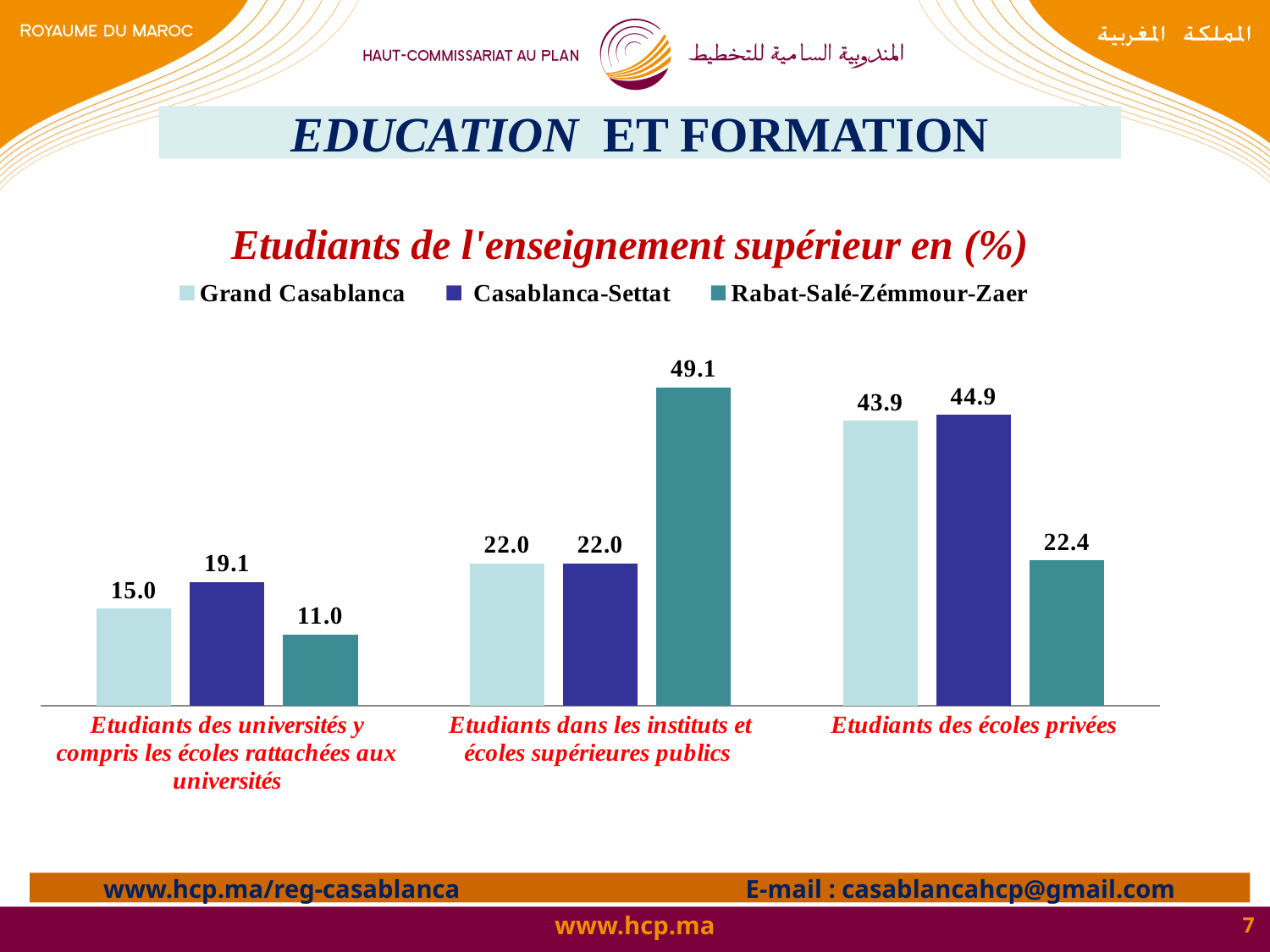
What kind of chart is shown on the slide? Bar chart What is the difference between the Casablanca-Settat and Grand Casablanca values for 'Etudiants des écoles privées'? 1.0 Which series has the highest value in the category 'Etudiants des écoles privées'? Casablanca-Settat What is the value for Rabat-Salé-Zémmour-Zaer in the category 'Etudiants dans les instituts et écoles supérieures publics'? 49.1 What is the difference between the Rabat-Salé-Zémmour-Zaer value and the Grand Casablanca value in the category 'Etudiants dans les instituts et écoles supérieures publics'? 27.1 What is the title of the chart? Etudiants de l'enseignement supérieur en (%) Which is larger: the Grand Casablanca value or the Rabat-Salé-Zémmour-Zaer value for 'Etudiants des écoles privées'? Grand Casablanca What is the value for Grand Casablanca in the category 'Etudiants des écoles privées'? 43.9 How many categories are shown on the x axis? 3 What is the value for Casablanca-Settat in the category 'Etudiants des universités y compris les écoles rattachées aux universités'? 19.1 How many series does the legend list? 3 Which series has the lowest value in the category 'Etudiants des universités y compris les écoles rattachées aux universités'? Rabat-Salé-Zémmour-Zaer